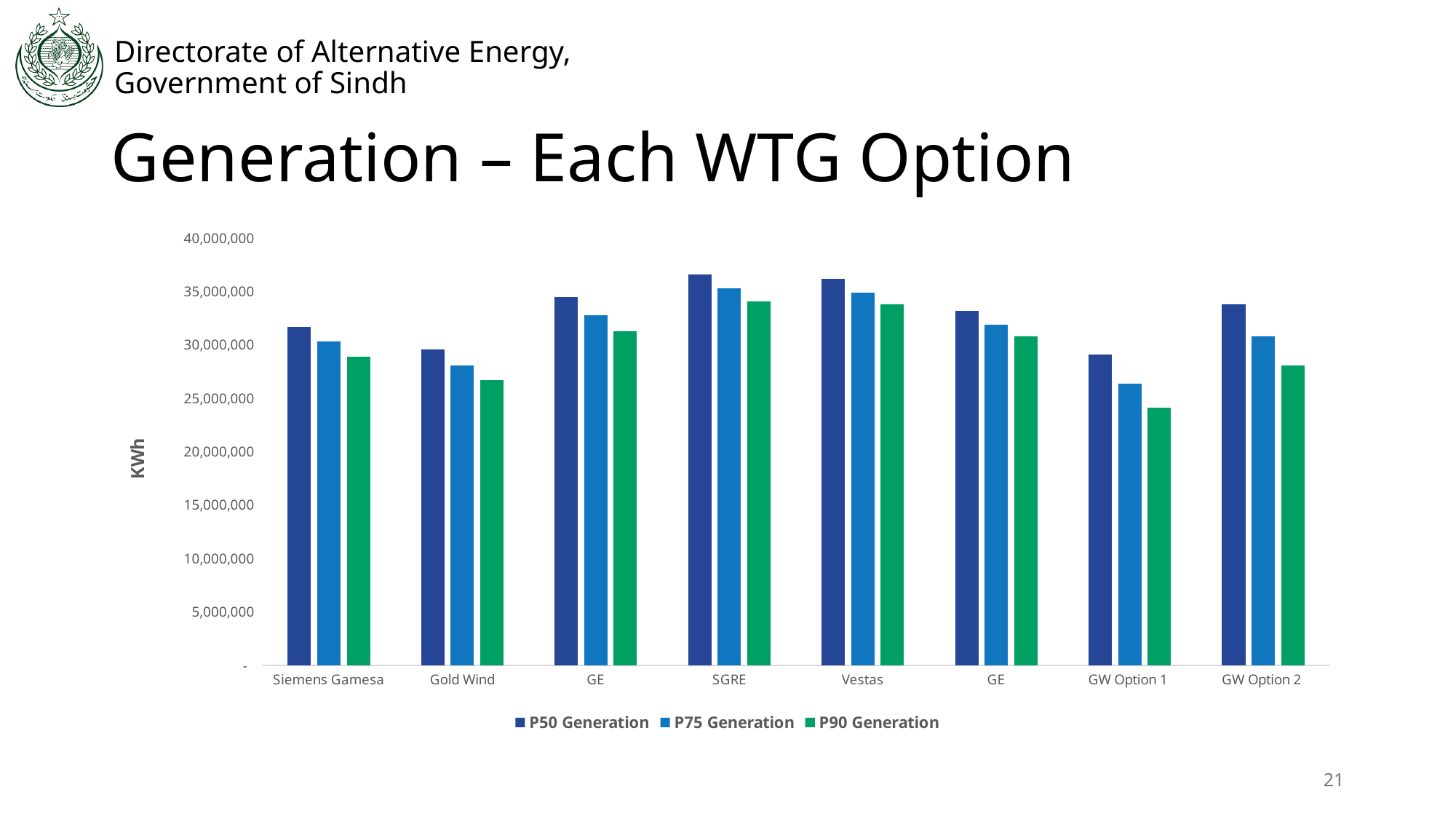
How many series does the legend list? 3 Is the P50 Generation value for GW Option 2 greater or less than 35,000,000? less What kind of chart is shown on the slide? bar chart How many WTG option categories are shown along the x axis? 8 Which has the larger P90 Generation value, GW Option 1 or GW Option 2? GW Option 2 Is the P90 Generation value for Gold Wind greater or less than 30,000,000? less Which category has the lowest P90 Generation value? GW Option 1 Which has the larger P50 Generation value, Siemens Gamesa or Gold Wind? Siemens Gamesa Is the P50 Generation value for SGRE greater or less than 35,000,000? greater What unit is shown on the vertical axis label? KWh